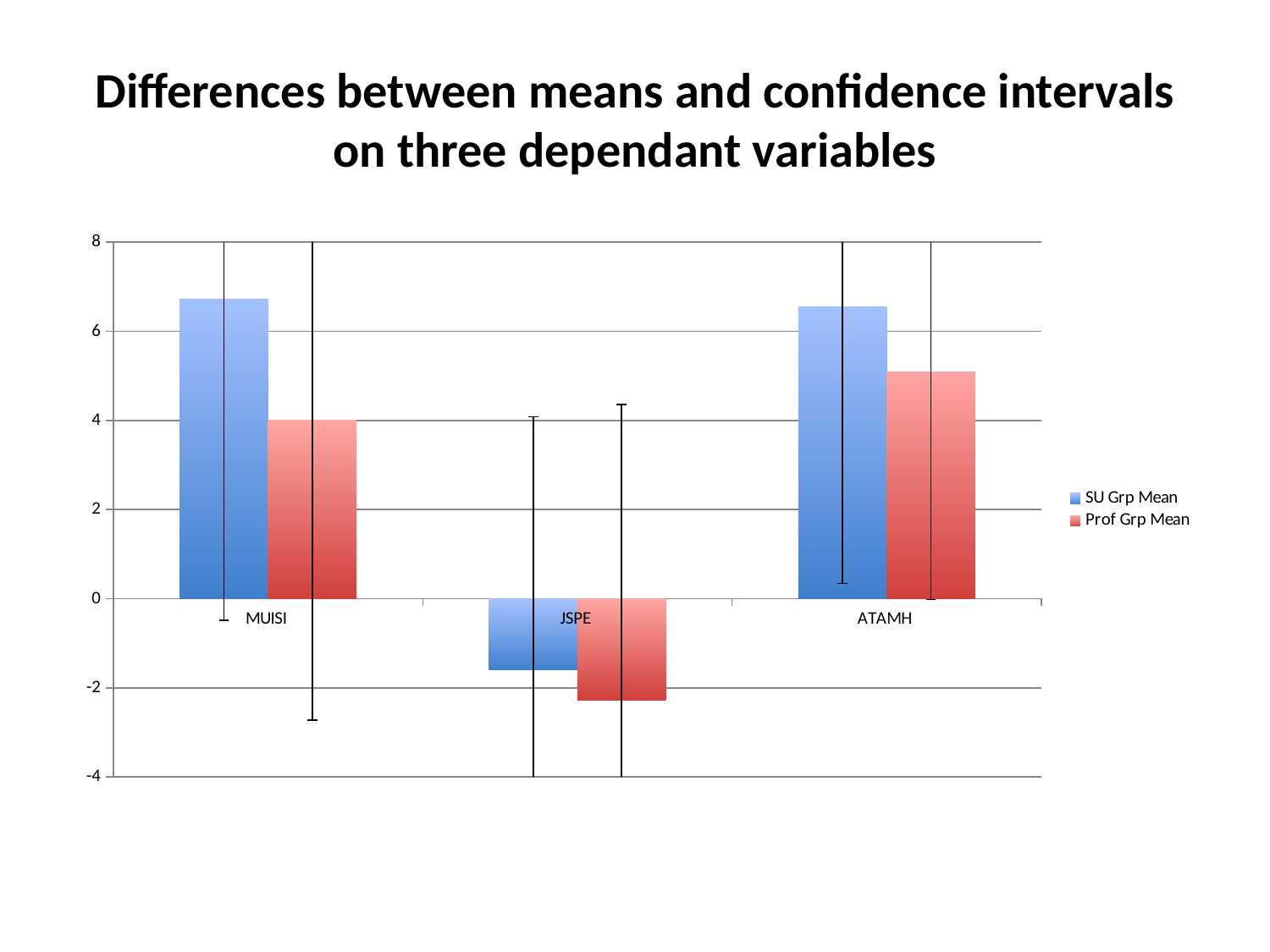
What kind of chart is shown on the slide? bar chart What is the title of the chart on the slide? Differences between means and confidence intervals on three dependant variables Which category has the highest Prof Grp Mean value? ATAMH Which series is shown in red in the chart? Prof Grp Mean Is the SU Grp Mean value for MUISI greater or less than 6? greater Is the Prof Grp Mean value for JSPE greater or less than -2? less For MUISI, which is larger: the SU Grp Mean or the Prof Grp Mean? SU Grp Mean For ATAMH, which is larger: the SU Grp Mean or the Prof Grp Mean? SU Grp Mean How many series does the chart's legend list? 2 Which category has the lowest Prof Grp Mean value? JSPE How many categories are shown on the x axis of the chart? 3 Which category has the highest SU Grp Mean value? MUISI